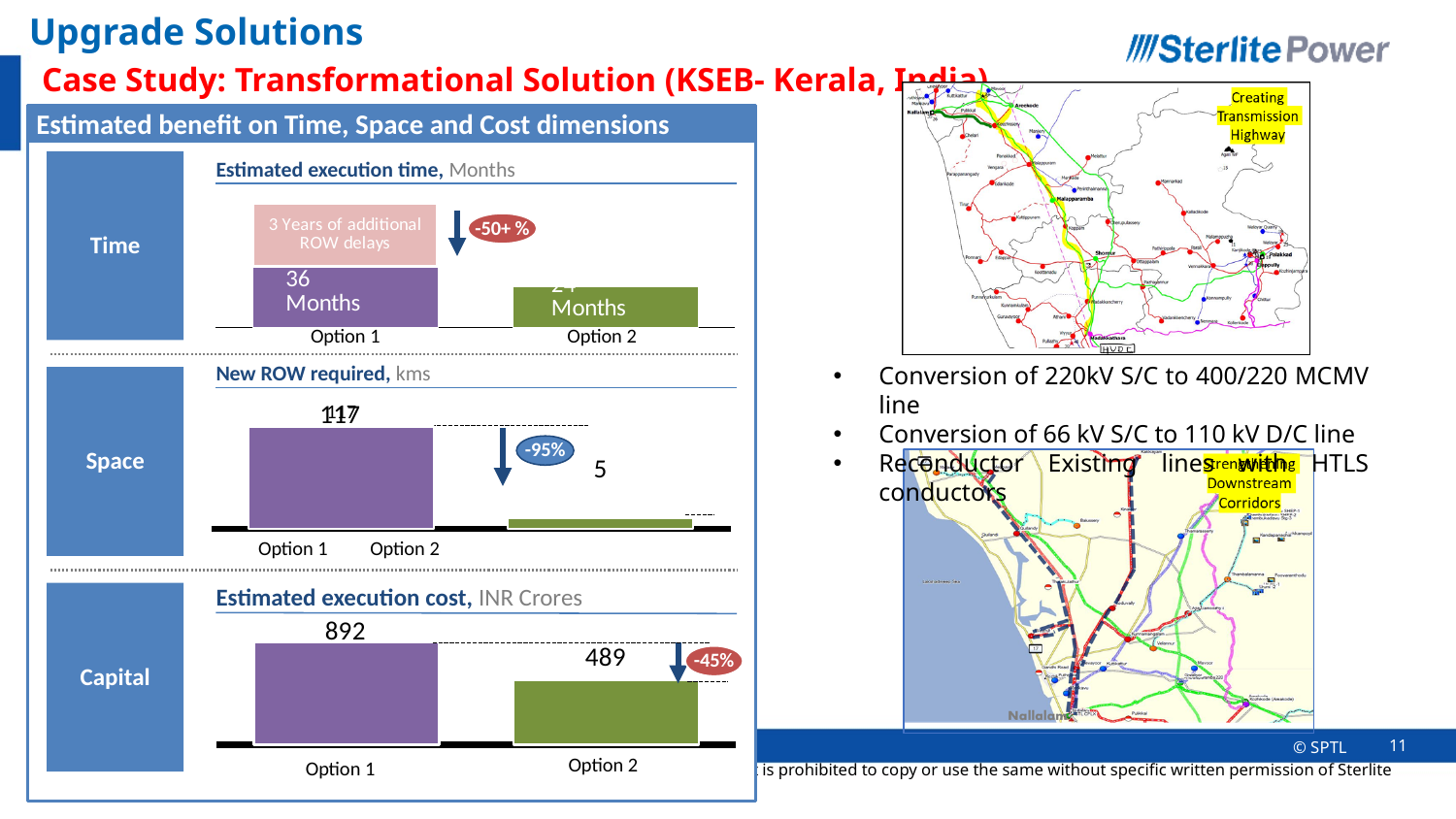
In the 'Estimated execution time' chart, what percentage reduction is shown in the callout? -50+ % In the 'New ROW required' chart, what is the value for Option 1? 117 In the 'Estimated execution cost' chart, what is the value for Option 2? 489 In the 'Estimated execution cost' chart, what is the difference between Option 1 and Option 2? 403 In the 'Estimated execution cost' chart, which option has the higher cost? Option 1 In the 'Estimated execution time' chart, what is the value for Option 1? 36 Months In the 'New ROW required' chart, what is the difference between Option 1 and Option 2? 112 What type of chart is the 'Estimated execution cost' chart? Bar chart In the 'Estimated execution time' chart, which option has the shorter execution time? Option 2 In the 'Estimated execution cost' chart, what is the value for Option 1? 892 In the 'New ROW required' chart, what percentage reduction is shown in the callout? -95% In the 'New ROW required' chart, what is the value for Option 2? 5